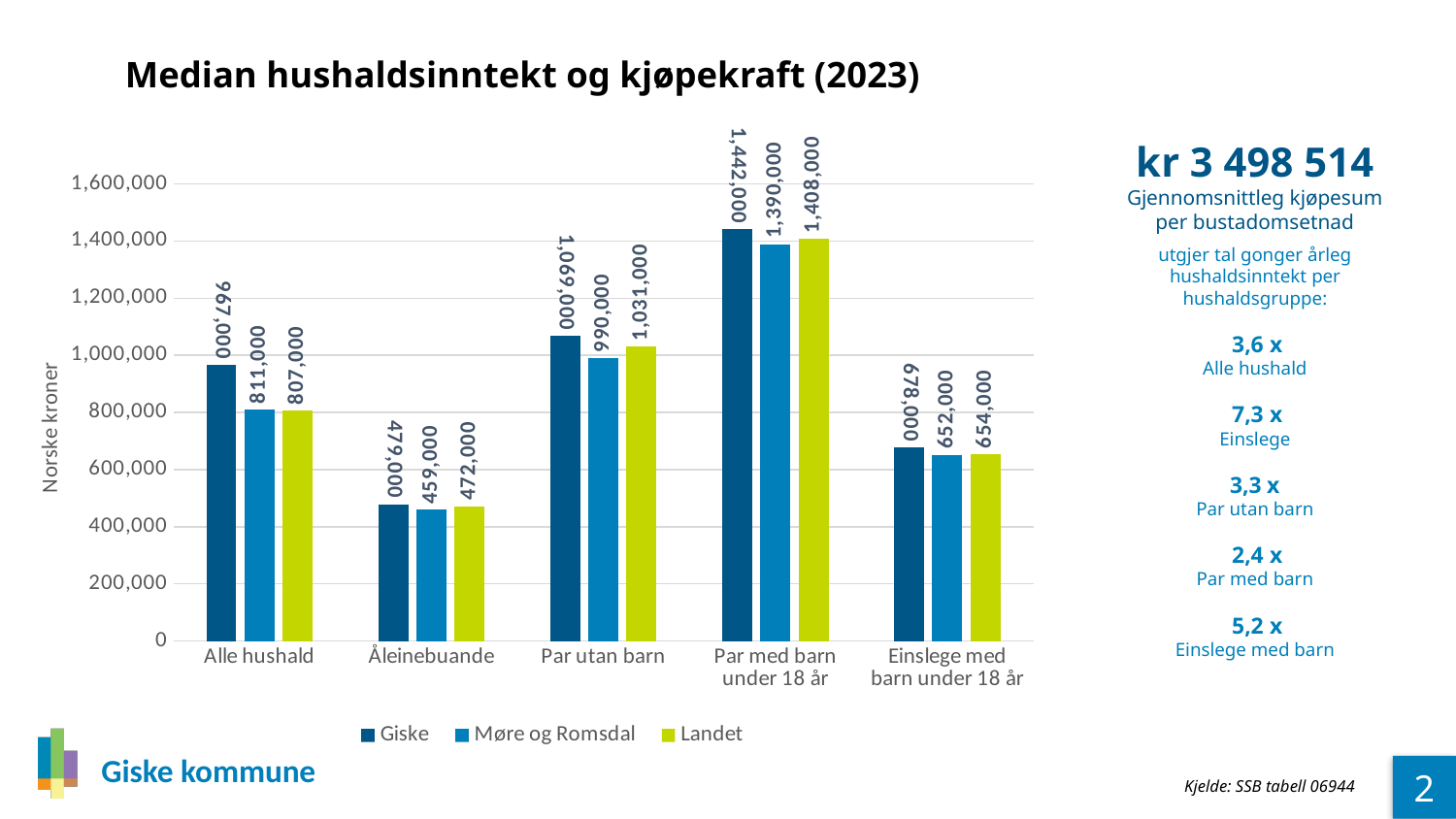
What is the value for Møre og Romsdal in the Åleinebuande category? 459,000 Which is larger in the Par utan barn category: Møre og Romsdal or Landet? Landet What is the value for Landet in the Par med barn under 18 år category? 1,408,000 Which category has the highest value for Giske? Par med barn under 18 år How many series does the legend list? 3 Is the value for Giske in the Einslege med barn under 18 år category greater or less than 600,000? greater What is the value for Giske in the Alle hushald category? 967,000 How many categories are shown on the x axis? 5 What is the label of the y axis? Norske kroner What kind of chart is shown on the slide? bar chart Which category has the lowest value for Landet? Åleinebuande What is the difference between the Giske and Møre og Romsdal values in the Alle hushald category? 156,000